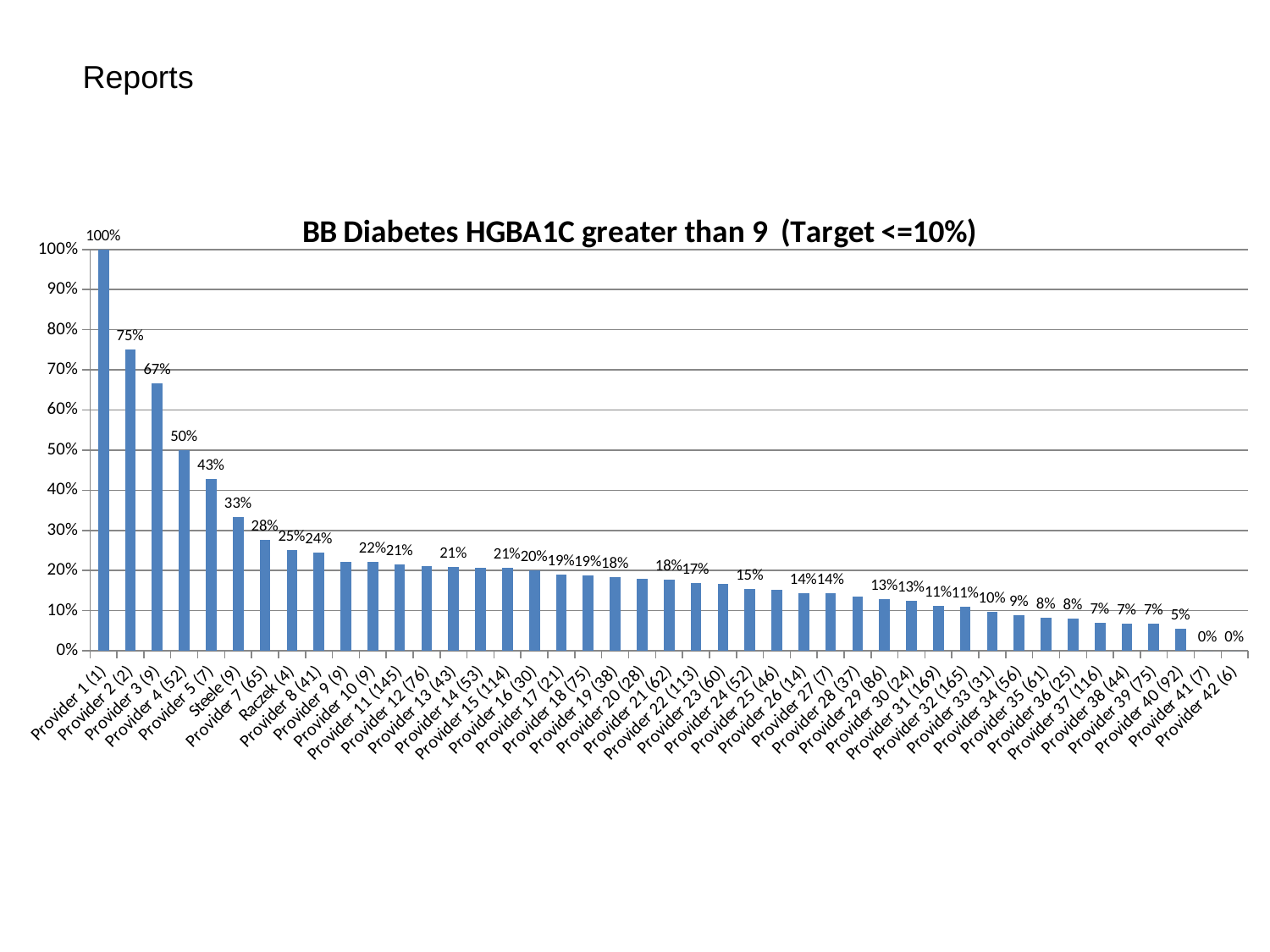
What is the value for Provider 40 (92)? 5% What is the difference between the values for Provider 1 (1) and Provider 2 (2)? 25% What is the value for Provider 2 (2)? 75% Which provider has the highest value? Provider 1 (1) What is the value for Steele (9)? 33% What kind of chart is this? bar chart What is the value for Raczek (4)? 25% What is the value for Provider 1 (1)? 100% Is the value for Provider 11 (145) greater or less than 30%? less How many providers are shown on the x axis? 43 Do the values rise or fall from left to right along the x axis? fall Which has the larger value, Provider 4 (52) or Provider 5 (7)? Provider 4 (52)